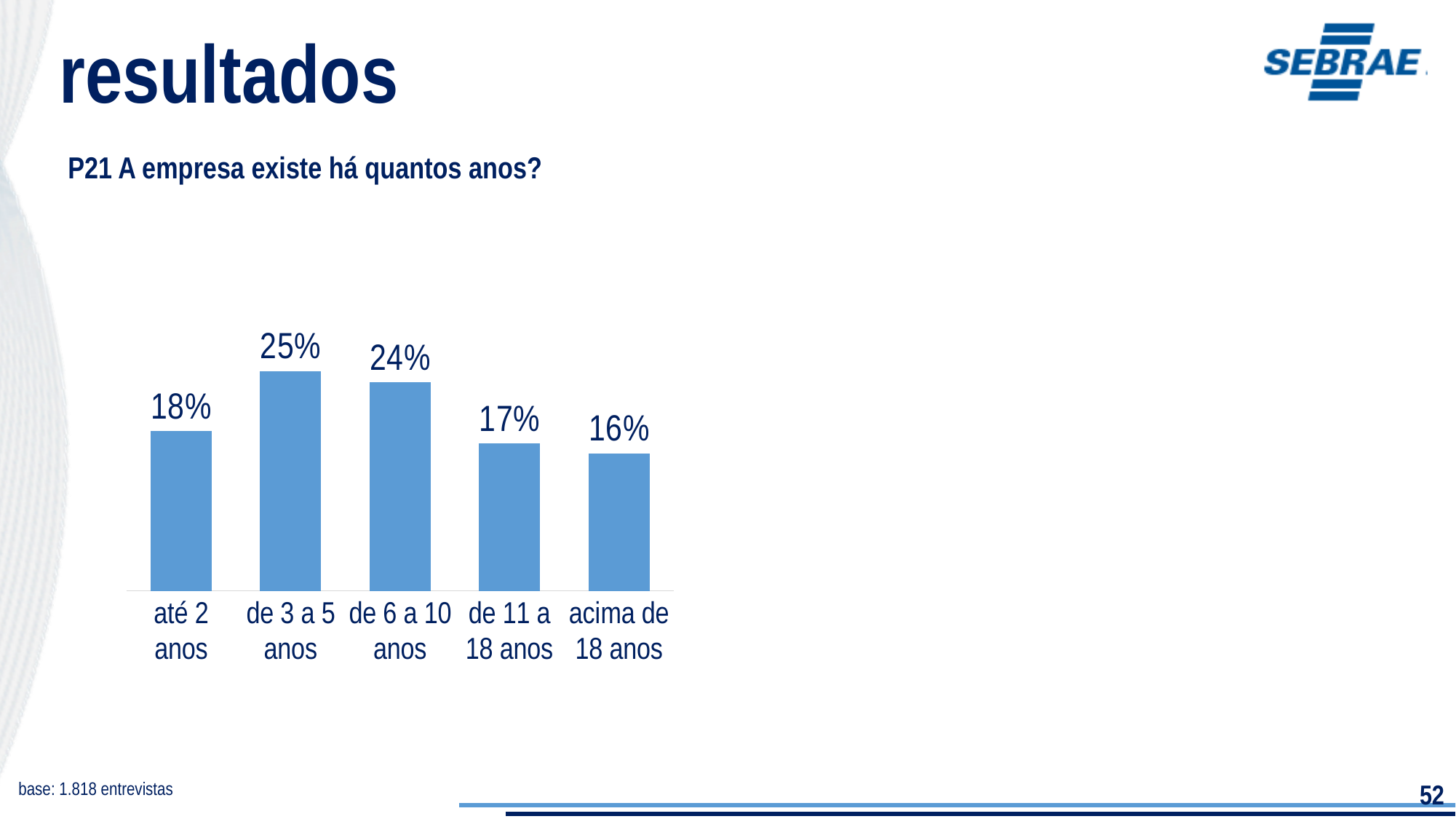
How many categories are shown in the chart? 5 What is the difference between the values for 'de 6 a 10 anos' and 'até 2 anos'? 6% Which is larger, the value for 'até 2 anos' or the value for 'de 11 a 18 anos'? até 2 anos What question does the chart on the slide answer? P21 A empresa existe há quantos anos? What is the value for 'de 3 a 5 anos'? 25% What is the value for 'até 2 anos'? 18% What is the value for 'de 11 a 18 anos'? 17% Which category has the lowest value? acima de 18 anos What is the difference between the values for 'de 3 a 5 anos' and 'acima de 18 anos'? 9% Which category has the highest value? de 3 a 5 anos What kind of chart is shown on the slide? bar chart What is the value for 'acima de 18 anos'? 16%